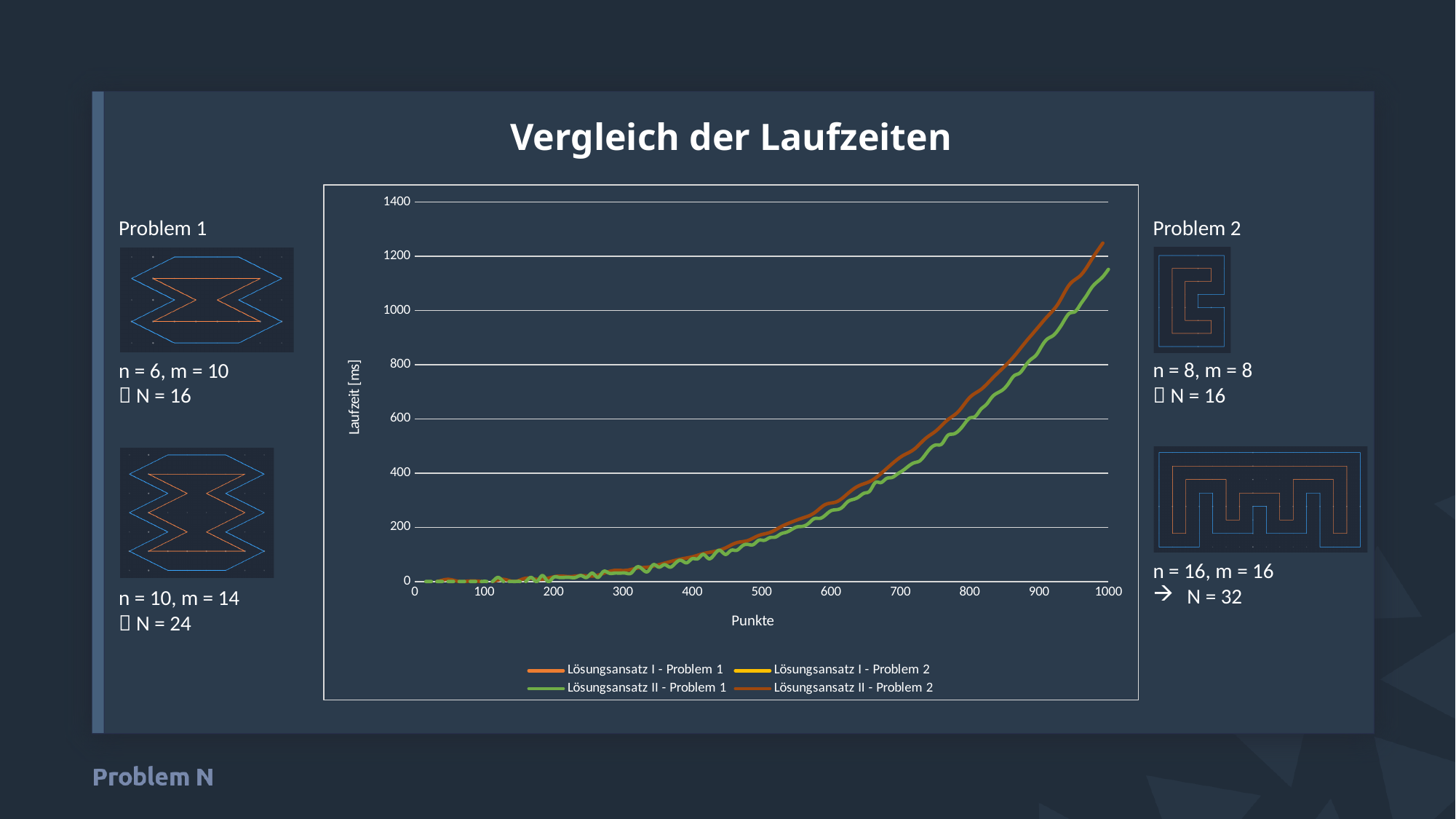
How many series does the chart's legend list? 4 What is the title of the chart? Vergleich der Laufzeiten What is the label of the y axis of the chart? Laufzeit [ms] What kind of chart is shown on the slide? line chart Is the value of the green line at 500 Punkte greater or less than 200 ms? less Is the value of the green line at 300 Punkte greater or less than 200 ms? less Do the plotted runtimes rise or fall as the number of Punkte increases along the x axis? rise Is the value of the green line at 1000 Punkte greater or less than 1000 ms? greater